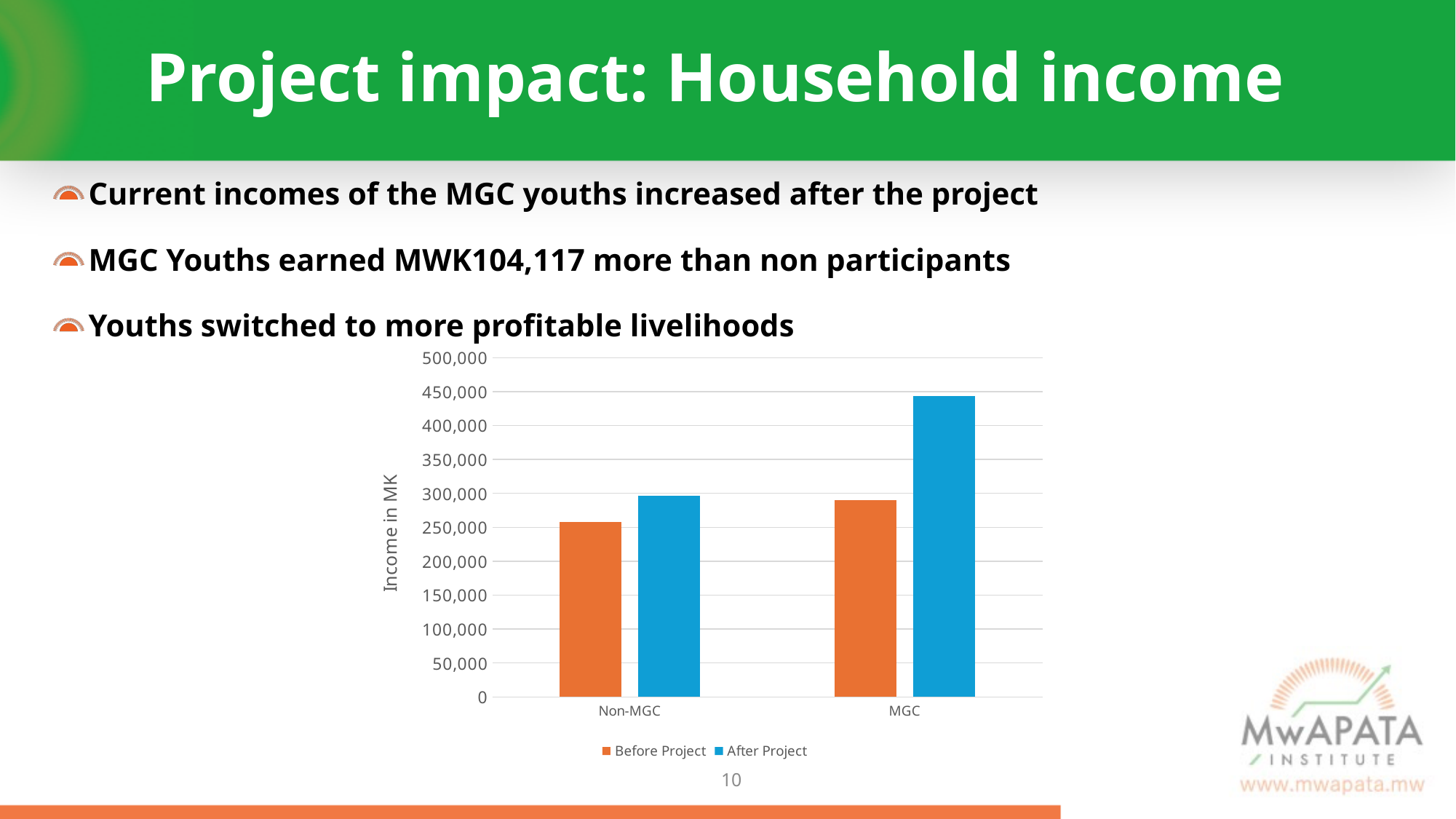
Which is larger: the After Project value for MGC or the After Project value for Non-MGC? MGC Which bar in the chart is the lowest? Non-MGC, Before Project What are the two series listed in the chart's legend? Before Project and After Project What kind of chart is shown on the slide? bar chart Is the Before Project value for MGC greater or less than 250,000? greater How many series does the chart's legend list? 2 Is the After Project value for MGC greater or less than 400,000? greater Which is larger: the Before Project value for MGC or the Before Project value for Non-MGC? MGC What is the title of the chart's vertical axis? Income in MK Is the Before Project value for Non-MGC greater or less than 300,000? less How many categories are shown on the x axis of the chart? 2 Which bar in the chart is the highest? MGC, After Project